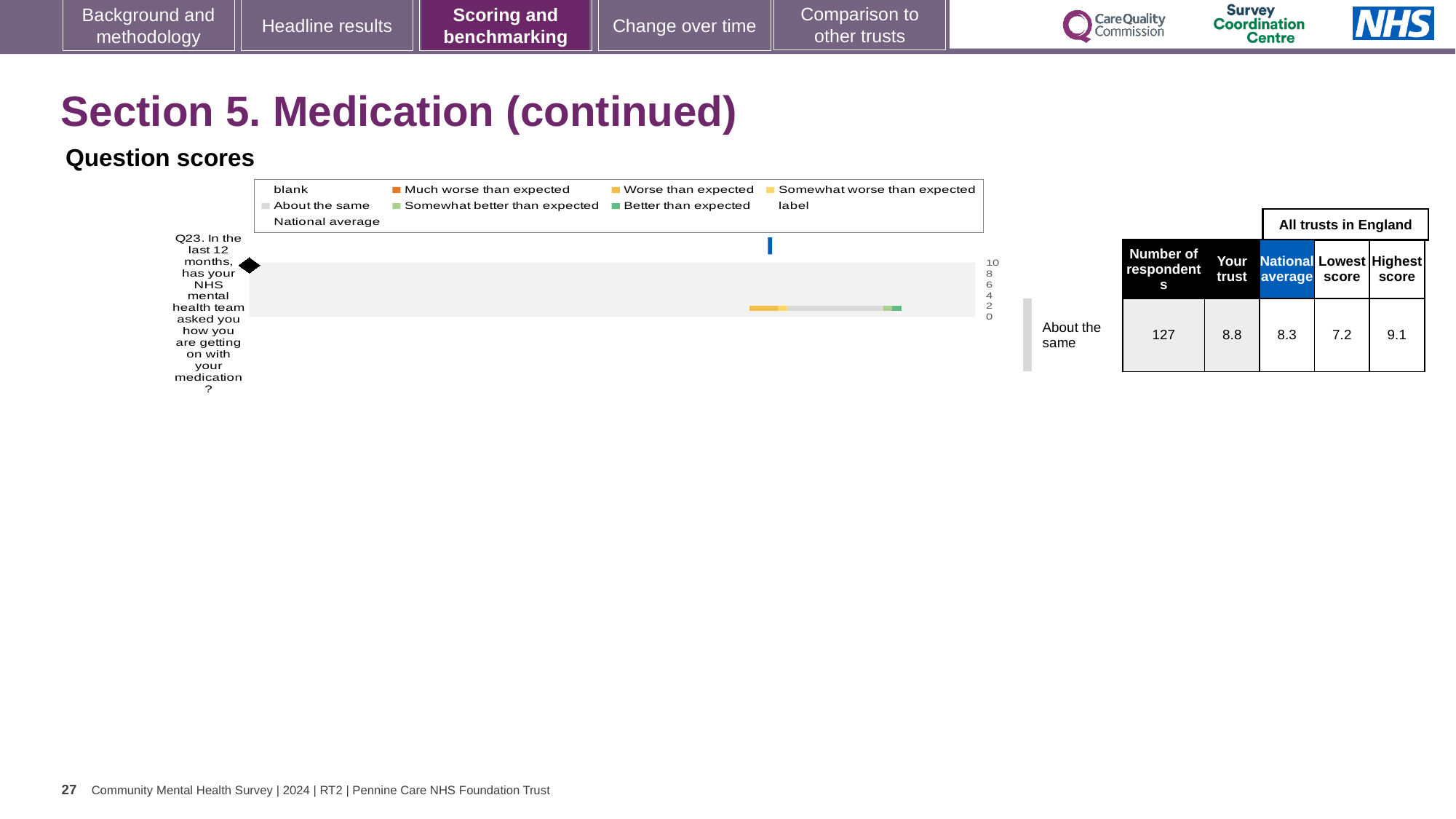
Which is larger for Q23, the 'Your trust' score or the national average? Your trust How many questions (categories) are plotted in the chart? 1 Which question is plotted in the chart? Q23. In the last 12 months, has your NHS mental health team asked you how you are getting on with your medication? In the table next to the chart, what is the lowest score among all trusts in England for Q23? 7.2 What benchmark category is given for Q23 next to the chart? About the same In the table next to the chart, what is the highest score among all trusts in England for Q23? 9.1 In the table next to the chart, what is the number of respondents for Q23? 127 In the table next to the chart, what is the national average score for Q23? 8.3 What kind of chart is shown under 'Question scores'? bar chart What is the highest value shown on the chart's axis? 10 In the table next to the chart, what is the 'Your trust' score for Q23? 8.8 What is the difference between the 'Your trust' score and the national average for Q23? 0.5